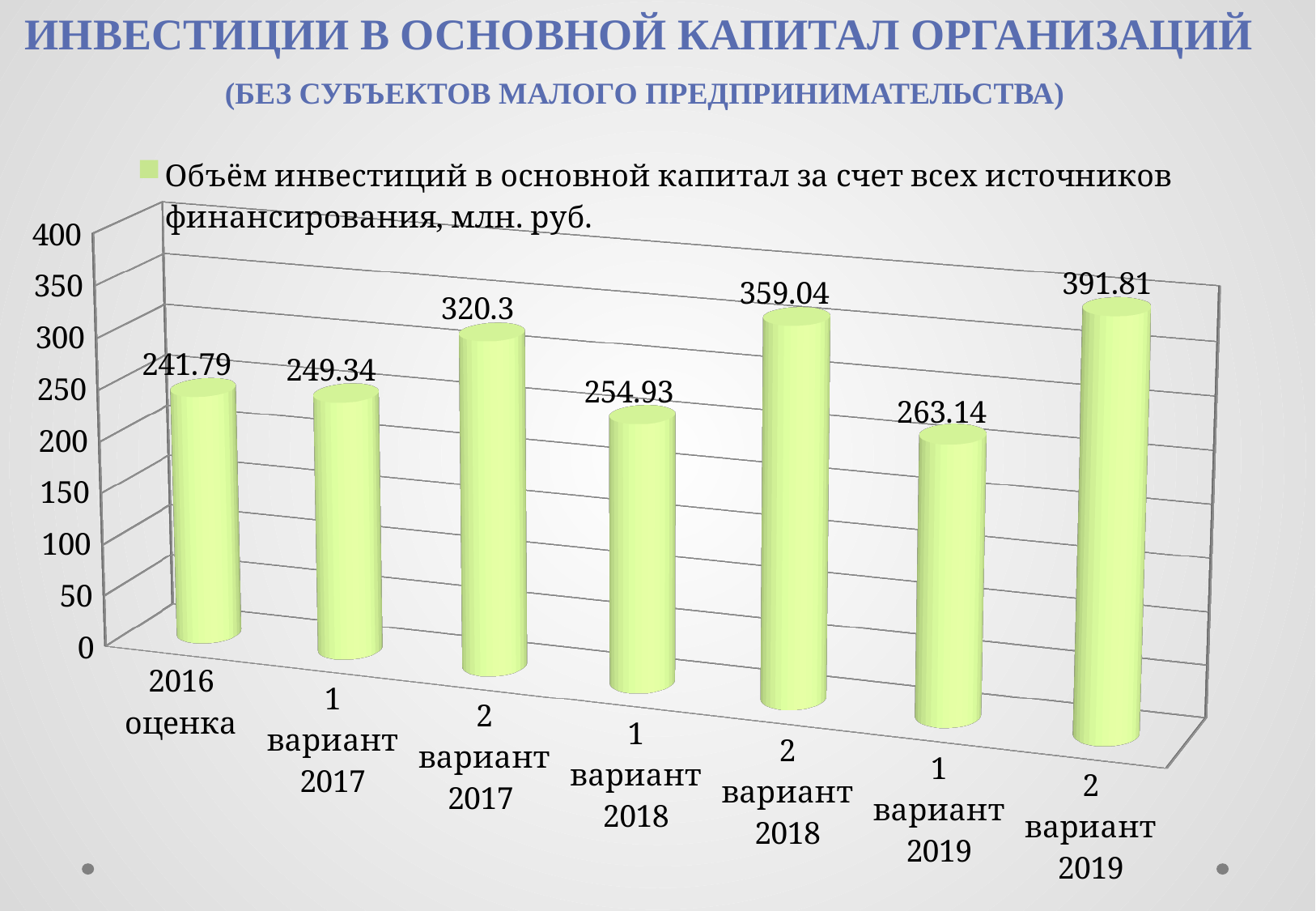
How many categories are shown on the x axis? 7 What is the value for "1 вариант 2019"? 263.14 What is the legend entry for the plotted series? Объём инвестиций в основной капитал за счет всех источников финансирования, млн. руб. Which category has the lowest value? 2016 оценка What kind of chart is shown on the slide? bar chart Which is larger, the value for "2 вариант 2017" or the value for "1 вариант 2018"? 2 вариант 2017 What is the value for "2 вариант 2018"? 359.04 What is the difference between the values for "2 вариант 2019" and "1 вариант 2019"? 128.67 What is the difference between the values for "2 вариант 2017" and "1 вариант 2017"? 70.96 What is the value for "2016 оценка"? 241.79 Is the value for "2 вариант 2018" greater or less than 300? greater Which category has the highest value? 2 вариант 2019